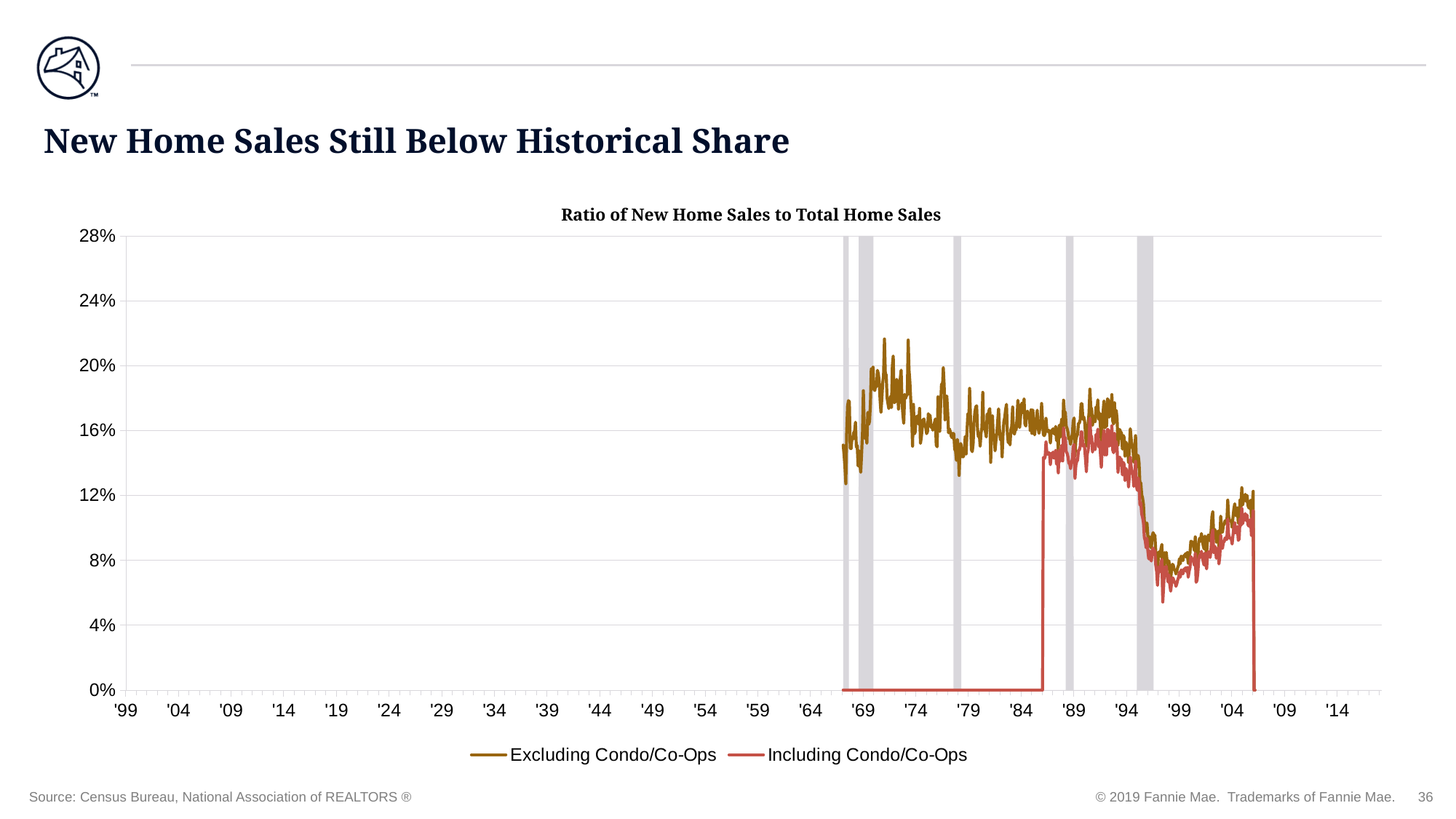
What is the highest value shown on the y axis? 28% Is the peak of the Excluding Condo/Co-Ops series in the early 1970s greater or less than 20%? greater Is the value of the Excluding Condo/Co-Ops series around '99 greater or less than 12%? less Is the value of the Including Condo/Co-Ops series around '99 greater or less than 12%? less Which series is drawn in red? Including Condo/Co-Ops What kind of chart is shown on the slide? line chart How many series does the legend list? 2 Which series is generally higher where both are plotted, Excluding Condo/Co-Ops or Including Condo/Co-Ops? Excluding Condo/Co-Ops What is the title of the chart? Ratio of New Home Sales to Total Home Sales Do the plotted values rise or fall between '94 and '99? fall